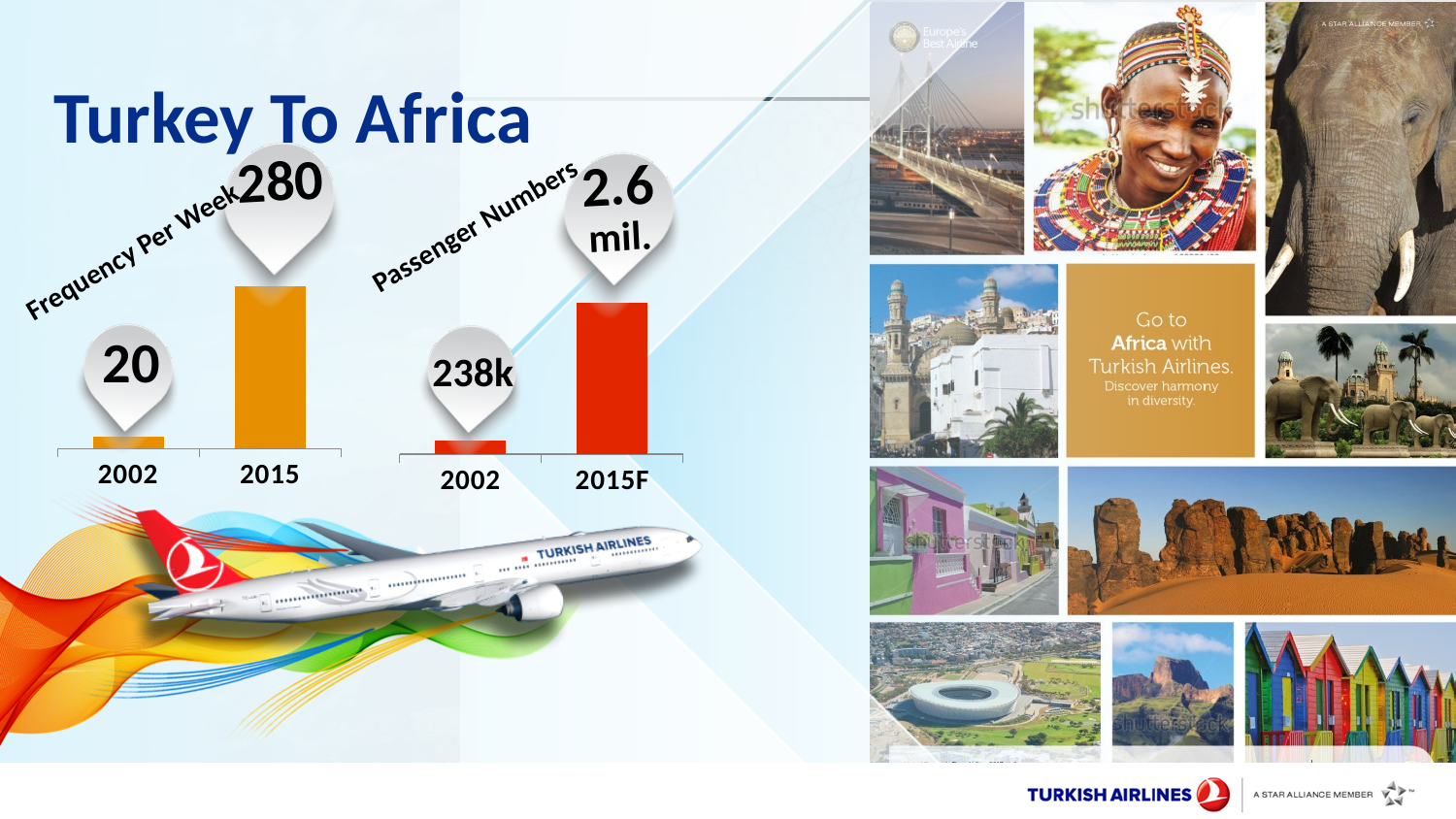
In the Passenger Numbers chart, what is the value for 2015F? 2.6 mil. How many categories are shown on the x axis of the Frequency Per Week chart? 2 In the Frequency Per Week chart, what is the value for 2015? 280 In the Passenger Numbers chart, what is the value for 2002? 238k In the Frequency Per Week chart, what is the difference between the 2015 and 2002 values? 260 In the Passenger Numbers chart, is the value for 2015F larger or smaller than the value for 2002? larger In the Frequency Per Week chart, which year has the higher value? 2015 What kind of chart is the Passenger Numbers chart? bar chart In the Frequency Per Week chart, do the values rise or fall from 2002 to 2015? rise In the Passenger Numbers chart, which category has the lower value? 2002 In the Frequency Per Week chart, what is the value for 2002? 20 What is the title of the slide containing the two charts? Turkey To Africa